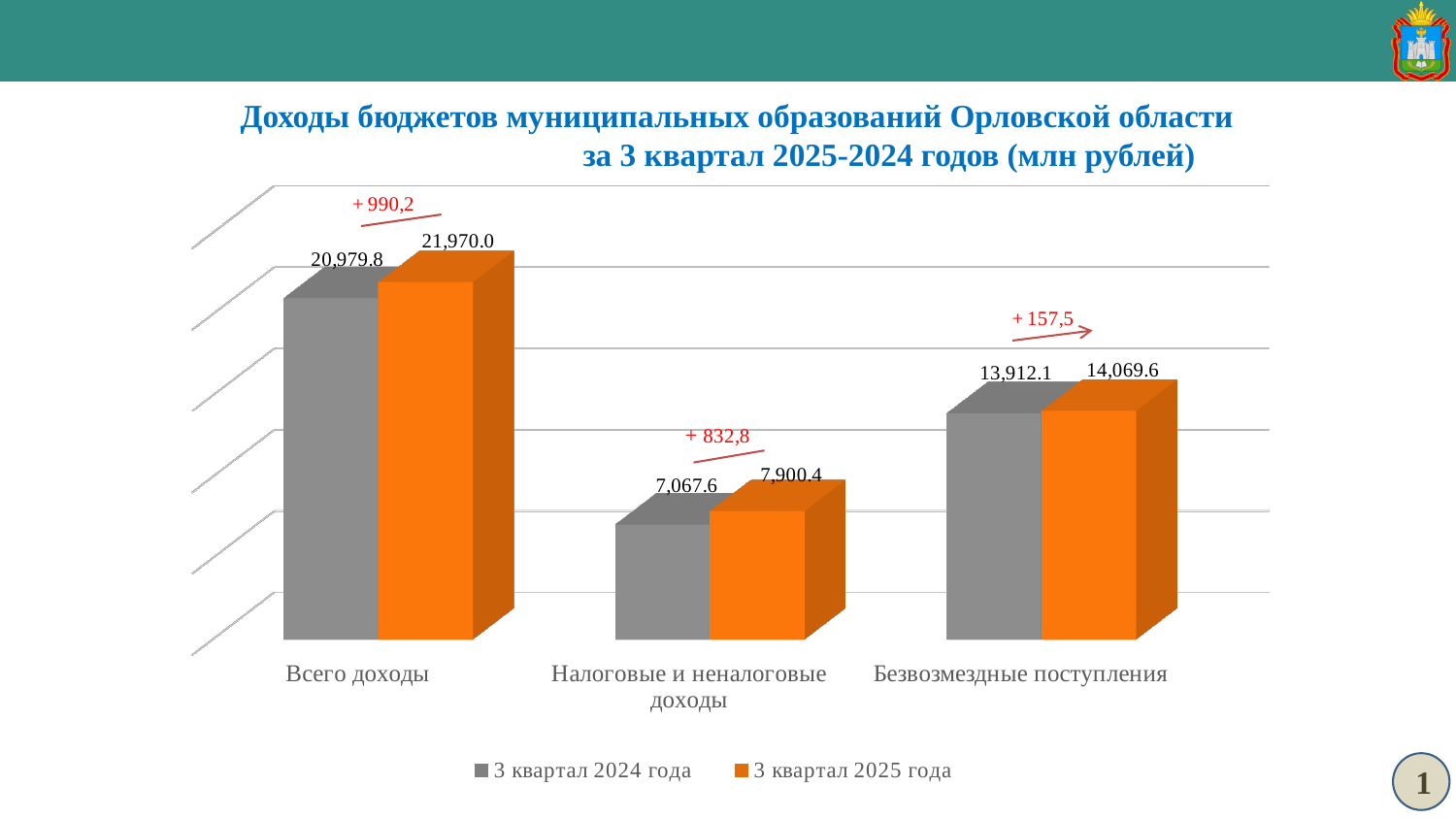
Which is larger for "Безвозмездные поступления": the "3 квартал 2024 года" value or the "3 квартал 2025 года" value? 3 квартал 2025 года What is the value for "Налоговые и неналоговые доходы" in the "3 квартал 2024 года" series? 7,067.6 What is the value for "Безвозмездные поступления" in the "3 квартал 2025 года" series? 14,069.6 Which category has the lowest value in the "3 квартал 2025 года" series? Налоговые и неналоговые доходы What is the value for "Всего доходы" in the "3 квартал 2025 года" series? 21,970.0 How many categories are shown on the x axis? 3 What is the difference between the "3 квартал 2025 года" and "3 квартал 2024 года" values for "Налоговые и неналоговые доходы"? 832.8 How many series does the legend list? 2 What kind of chart is shown on the slide? Bar chart What colour are the bars for the "3 квартал 2025 года" series? Orange Which category has the highest value in the "3 квартал 2024 года" series? Всего доходы What is the value for "Всего доходы" in the "3 квартал 2024 года" series? 20,979.8